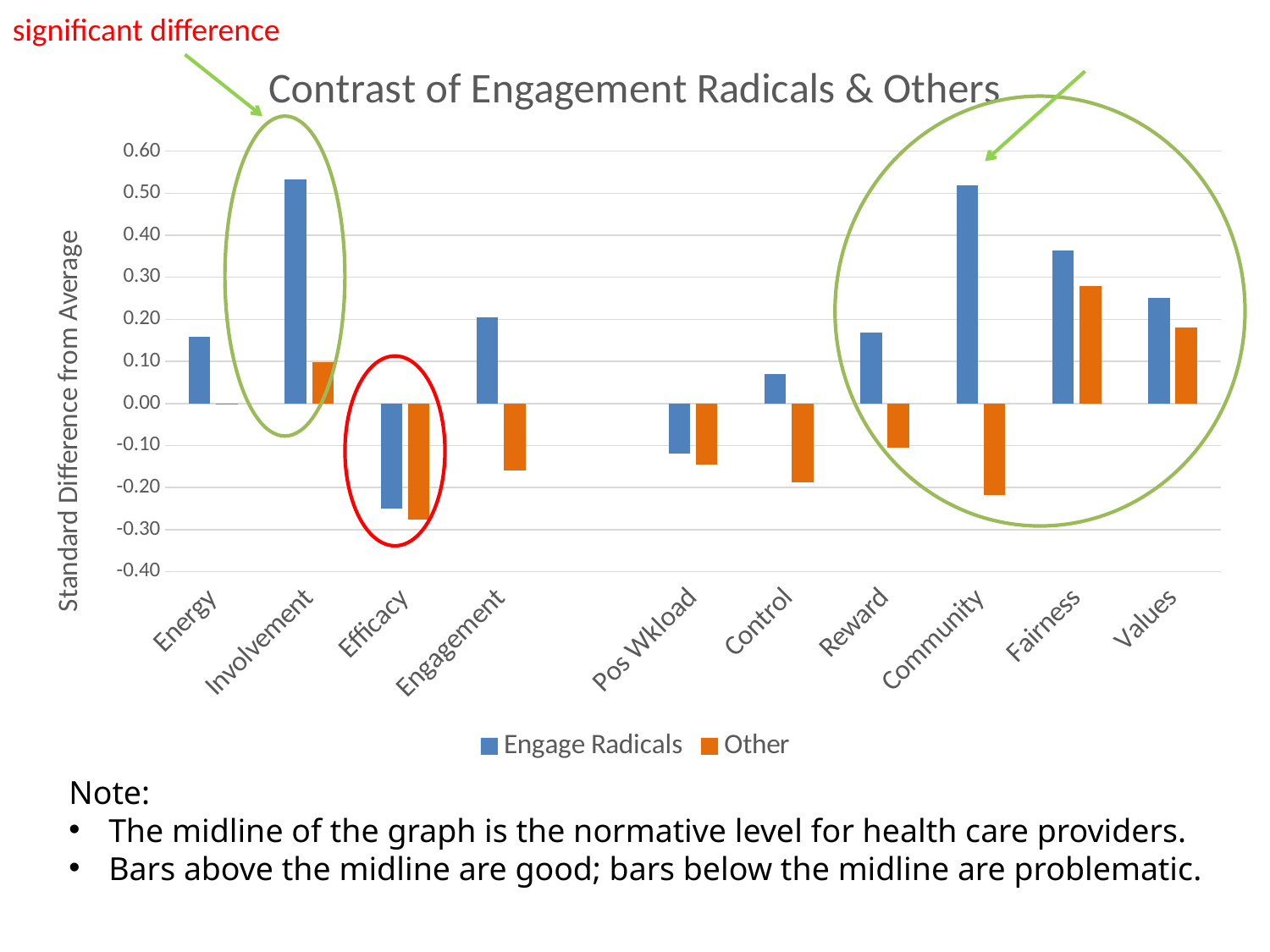
Which category has the lowest value for the Engage Radicals series? Efficacy For Fairness, which series has the larger value, Engage Radicals or Other? Engage Radicals Is the Other value for Efficacy greater or less than -0.20? less Which category has the highest value for the Other series? Fairness Is the Other value for Control greater or less than -0.10? less Is the Engage Radicals value for Community greater or less than 0.40? greater How many series does the chart legend list? 2 What is the title of the chart? Contrast of Engagement Radicals & Others For Values, which series has the larger value, Engage Radicals or Other? Engage Radicals What type of chart is shown on the slide? Bar chart What is the label of the vertical axis? Standard Difference from Average